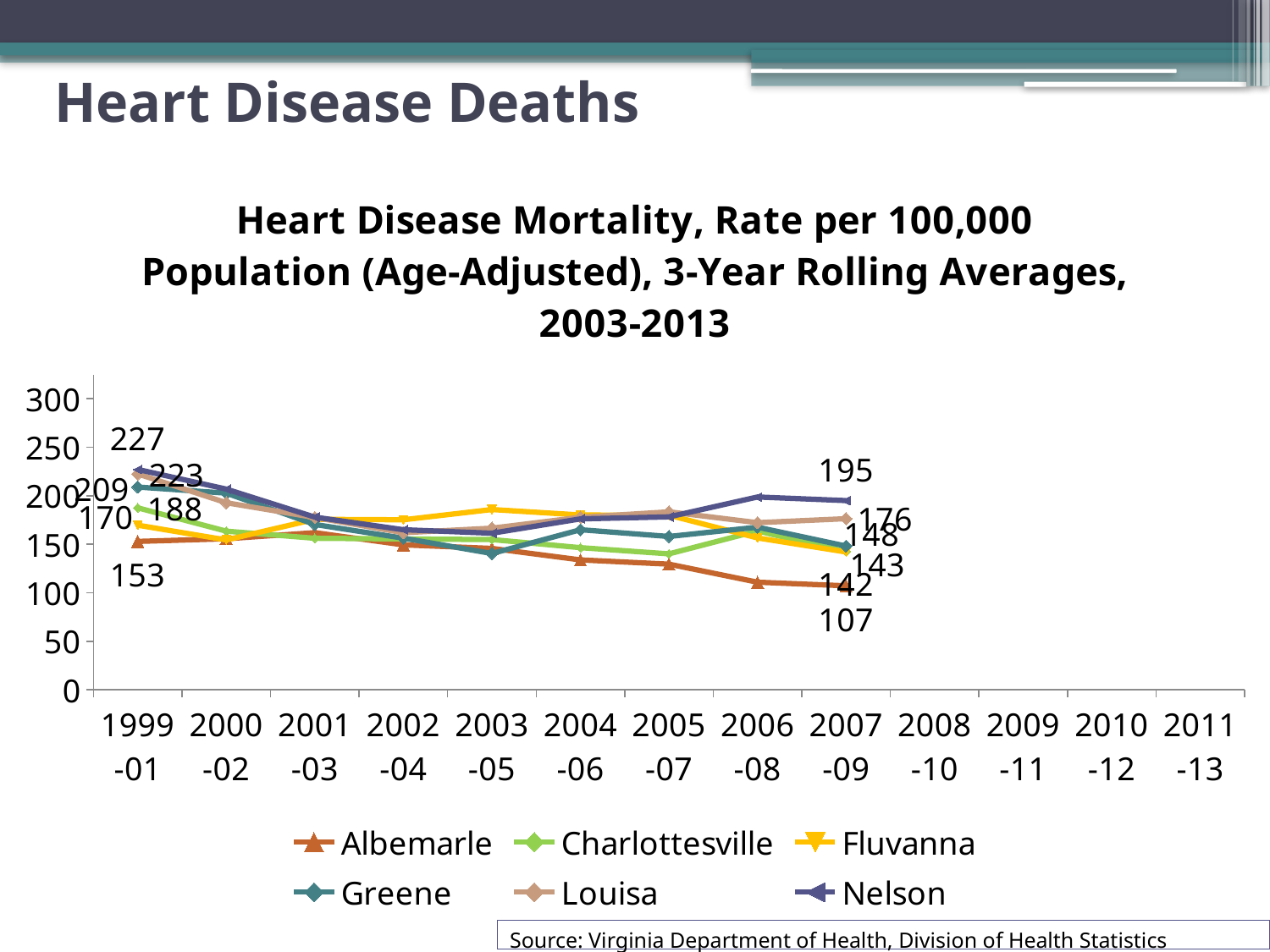
What is the value for Albemarle in 1999-01? 153 By how much did Nelson's value fall from 1999-01 to 2007-09? 32 How many series does the legend list? 6 What is the value for Albemarle in 2007-09? 107 Which locality has the lowest value in 2007-09? Albemarle Does the Albemarle line rise or fall from 1999-01 to 2007-09? fall What is the value for Louisa in 2007-09? 176 What is the value for Nelson in 1999-01? 227 How many year ranges are labelled on the x axis? 13 What is the value for Nelson in 2007-09? 195 Which locality has the highest value in 2007-09? Nelson What kind of chart is shown on the slide? line chart